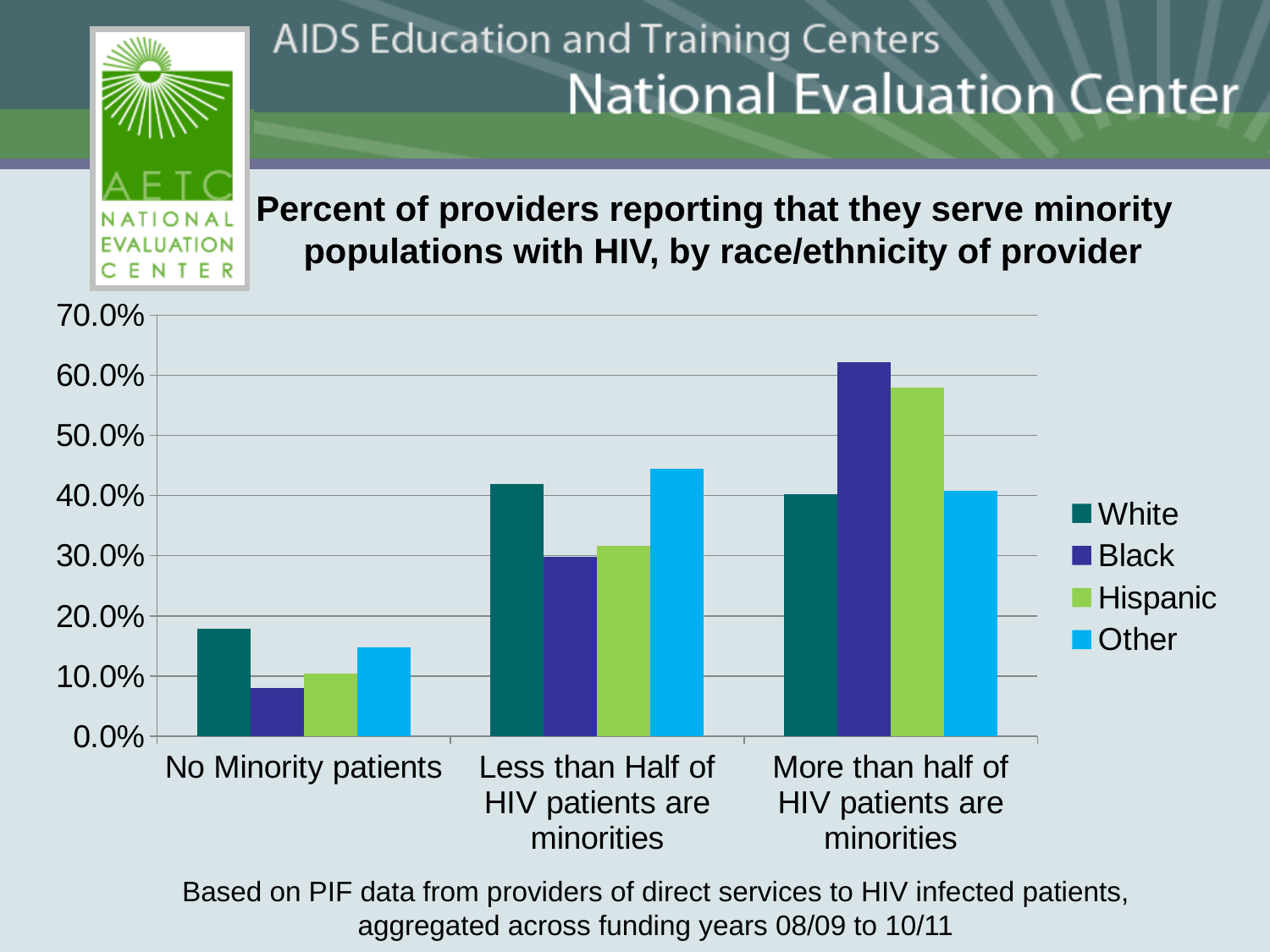
Which provider group has the highest value in the 'More than half of HIV patients are minorities' category? Black What kind of chart is shown on the slide? bar chart Which legend entry is shown in light green? Hispanic Is the value for Black providers in the 'More than half of HIV patients are minorities' category greater or less than 60.0%? greater Which provider group has the lowest value in the 'No Minority patients' category? Black Is the value for Hispanic providers in the 'More than half of HIV patients are minorities' category greater or less than 50.0%? greater Which provider group has the highest value in the 'No Minority patients' category? White How many categories are shown on the x axis? 3 How many series does the legend list? 4 Do the values for Black providers rise or fall across the categories from left to right? rise In the 'Less than Half of HIV patients are minorities' category, which is larger: the value for White providers or for Black providers? White Is the value for White providers in the 'No Minority patients' category greater or less than 20.0%? less